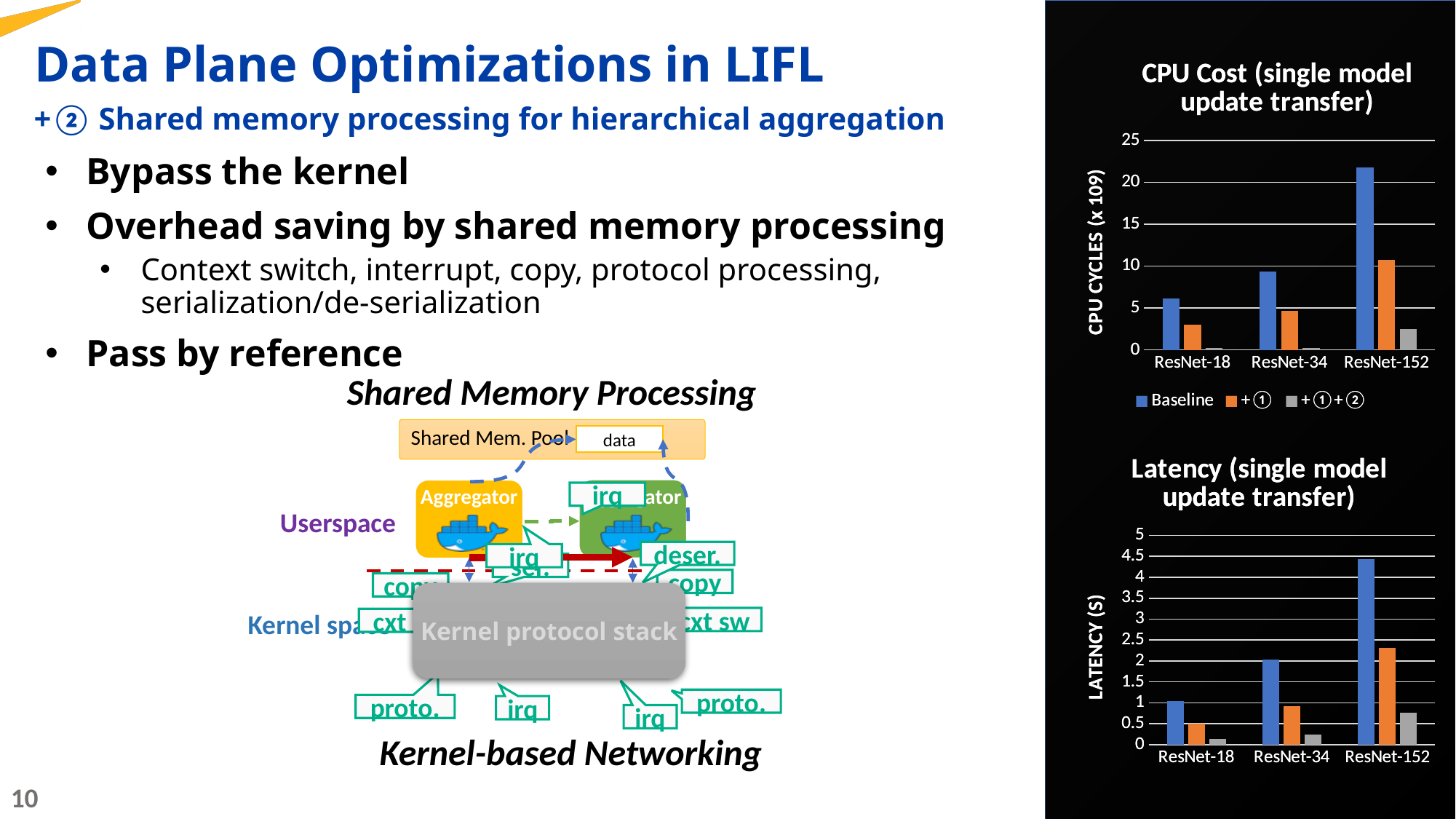
In the "CPU Cost (single model update transfer)" chart, is the Baseline value for ResNet-152 greater or less than 20? greater How many series does the legend of the "CPU Cost (single model update transfer)" chart list? 3 In the "Latency (single model update transfer)" chart, is the Baseline latency for ResNet-152 greater or less than 4? greater How many model categories are shown on the x axis of the "Latency (single model update transfer)" chart? 3 In the "Latency (single model update transfer)" chart, which is larger for ResNet-34: the Baseline bar or the orange bar? Baseline What kind of chart is the "CPU Cost (single model update transfer)" chart? bar chart In the "CPU Cost (single model update transfer)" chart, what colour are the Baseline bars? blue In the "CPU Cost (single model update transfer)" chart, which series has the lowest value for ResNet-18? +①+② In the "CPU Cost (single model update transfer)" chart, which model has the highest Baseline CPU cycles? ResNet-152 What is the y-axis label of the "Latency (single model update transfer)" chart? LATENCY (S) In the "Latency (single model update transfer)" chart, do the Baseline values rise or fall from ResNet-18 to ResNet-152? rise In the "CPU Cost (single model update transfer)" chart, is the +① value for ResNet-152 greater or less than 15? less